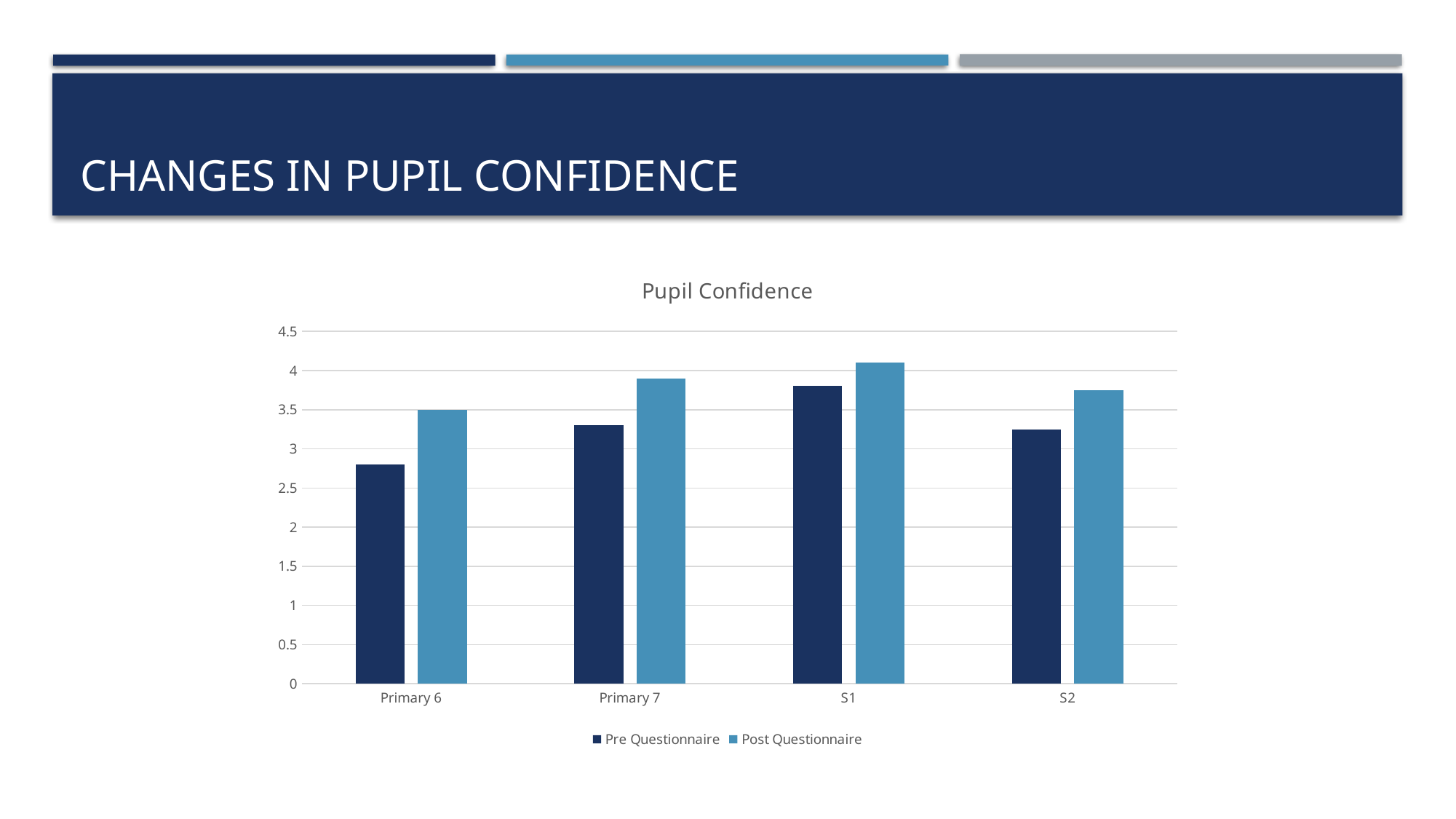
Is the Pre Questionnaire value for Primary 6 greater or less than 3? less Is the Post Questionnaire value for Primary 7 greater or less than 3.5? greater What kind of chart is shown on the slide? Bar chart Which year group has the highest Post Questionnaire value? S1 What is the title of the chart? Pupil Confidence Is the Pre Questionnaire value for S1 greater or less than 4? less In every year group, is the Post Questionnaire bar higher or lower than the Pre Questionnaire bar? Higher Which is larger, the Pre Questionnaire value for S1 or the Pre Questionnaire value for Primary 7? S1 Which year group has the lowest Pre Questionnaire value? Primary 6 How many series does the legend list? 2 How many year groups are shown on the x axis? 4